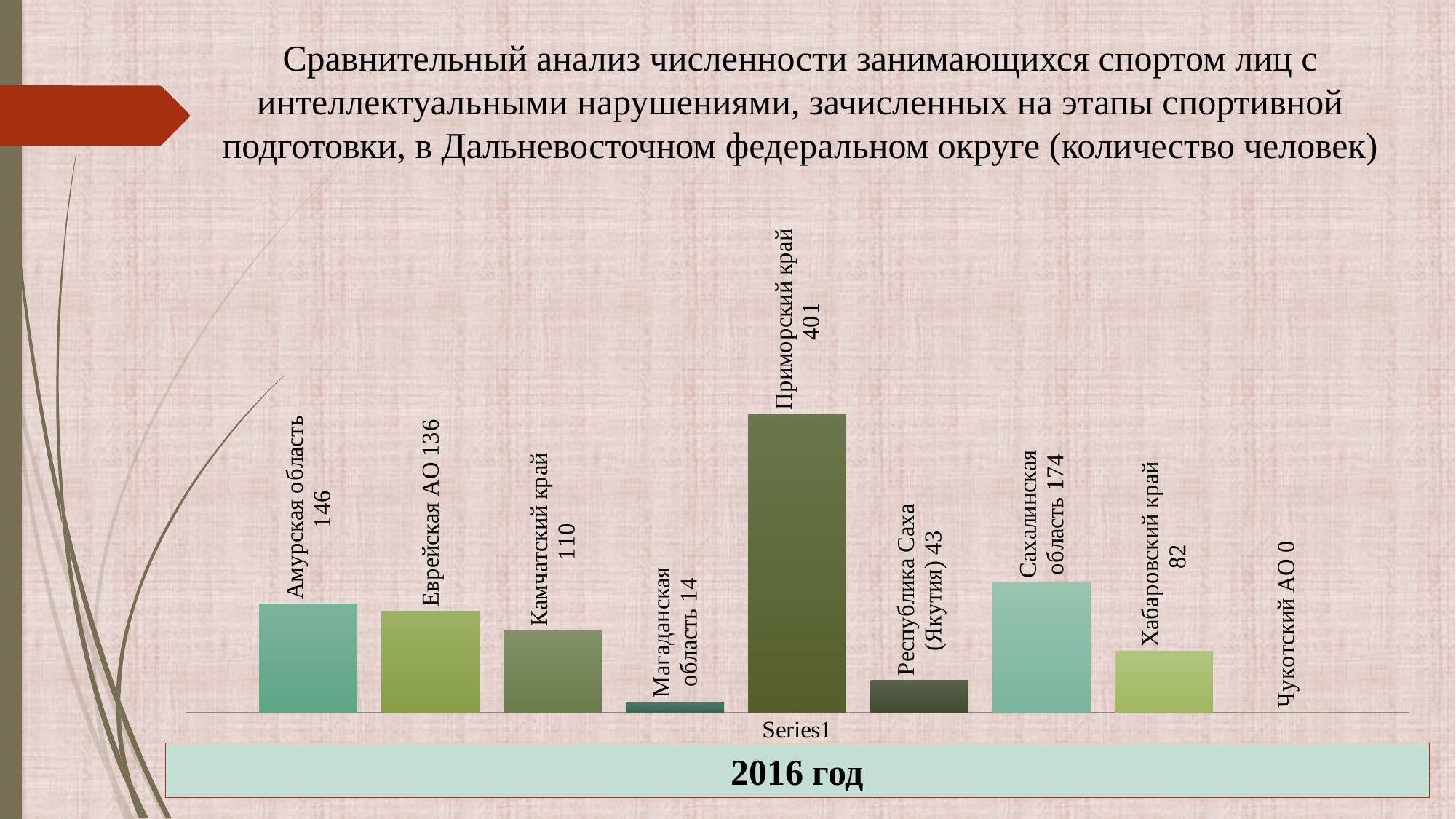
What is the value for Сахалинская область? 174 What is the value for Приморский край? 401 Which region has the lowest value? Чукотский АО What is the difference between the values for Амурская область and Еврейская АО? 10 What is the value for Магаданская область? 14 Which year does the chart refer to, according to the label below it? 2016 год Which is larger, the value for Камчатский край or the value for Республика Саха (Якутия)? Камчатский край Which region has the highest value? Приморский край What is the difference between the values for Приморский край and Сахалинская область? 227 What is the value for Хабаровский край? 82 How many regions are shown in the chart? 9 What kind of chart is shown on the slide? Bar chart